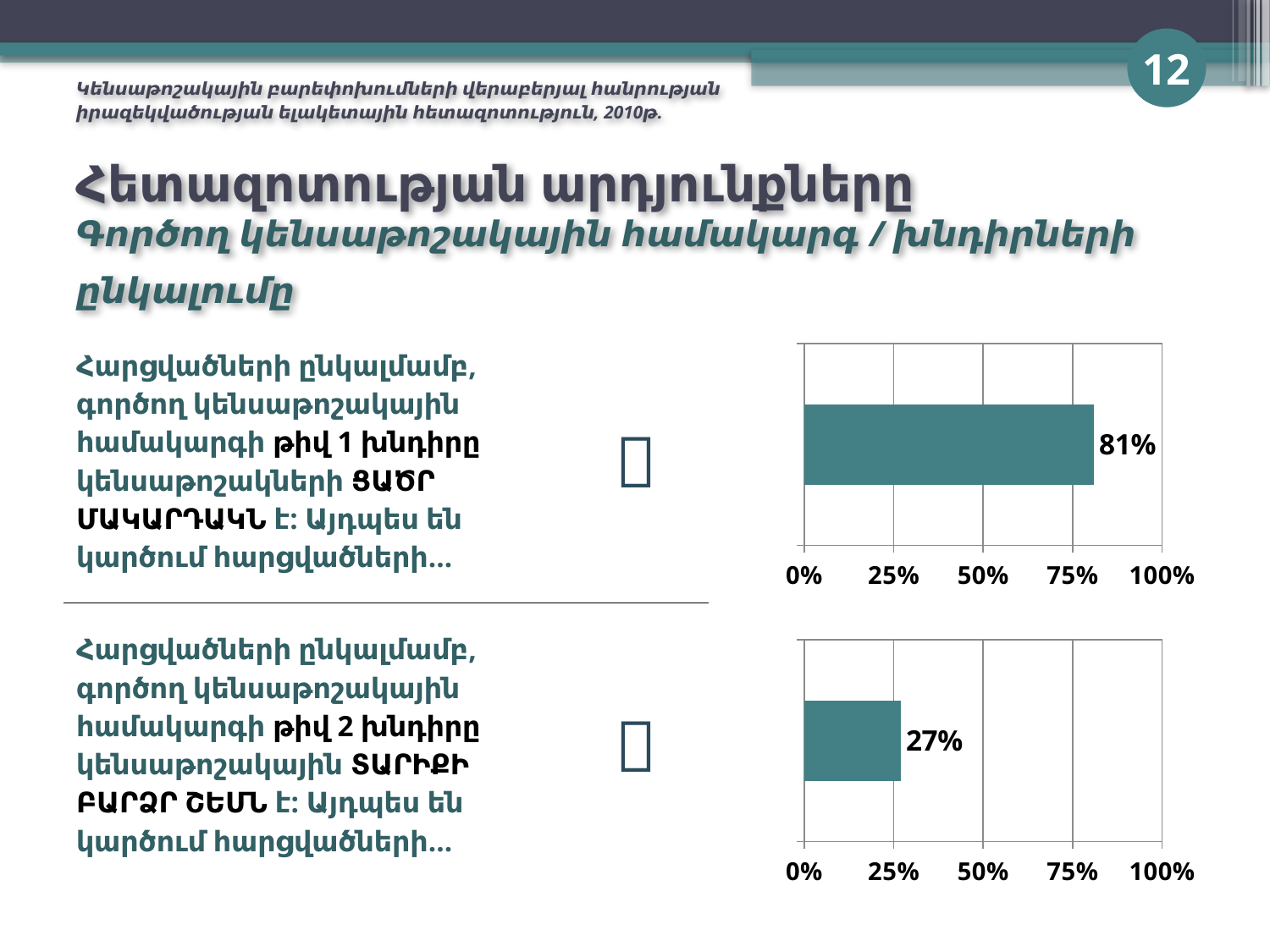
In the top chart, what value is shown on the bar? 81% In the bottom chart, what value is shown on the bar? 27% Is the value in the bottom chart greater or less than 50%? less What kind of chart is the bottom chart? bar chart How many bars are plotted in the bottom chart? 1 Which chart shows the larger value, the top chart or the bottom chart? the top chart Is the value in the top chart greater or less than 75%? greater What is the highest value labelled on the x axis of the bottom chart? 100% Are the bars in the top and bottom charts oriented horizontally or vertically? horizontally What kind of chart is the top chart? bar chart How many bars are plotted in the top chart? 1 What is the difference between the value in the top chart (81%) and the value in the bottom chart (27%)? 54%